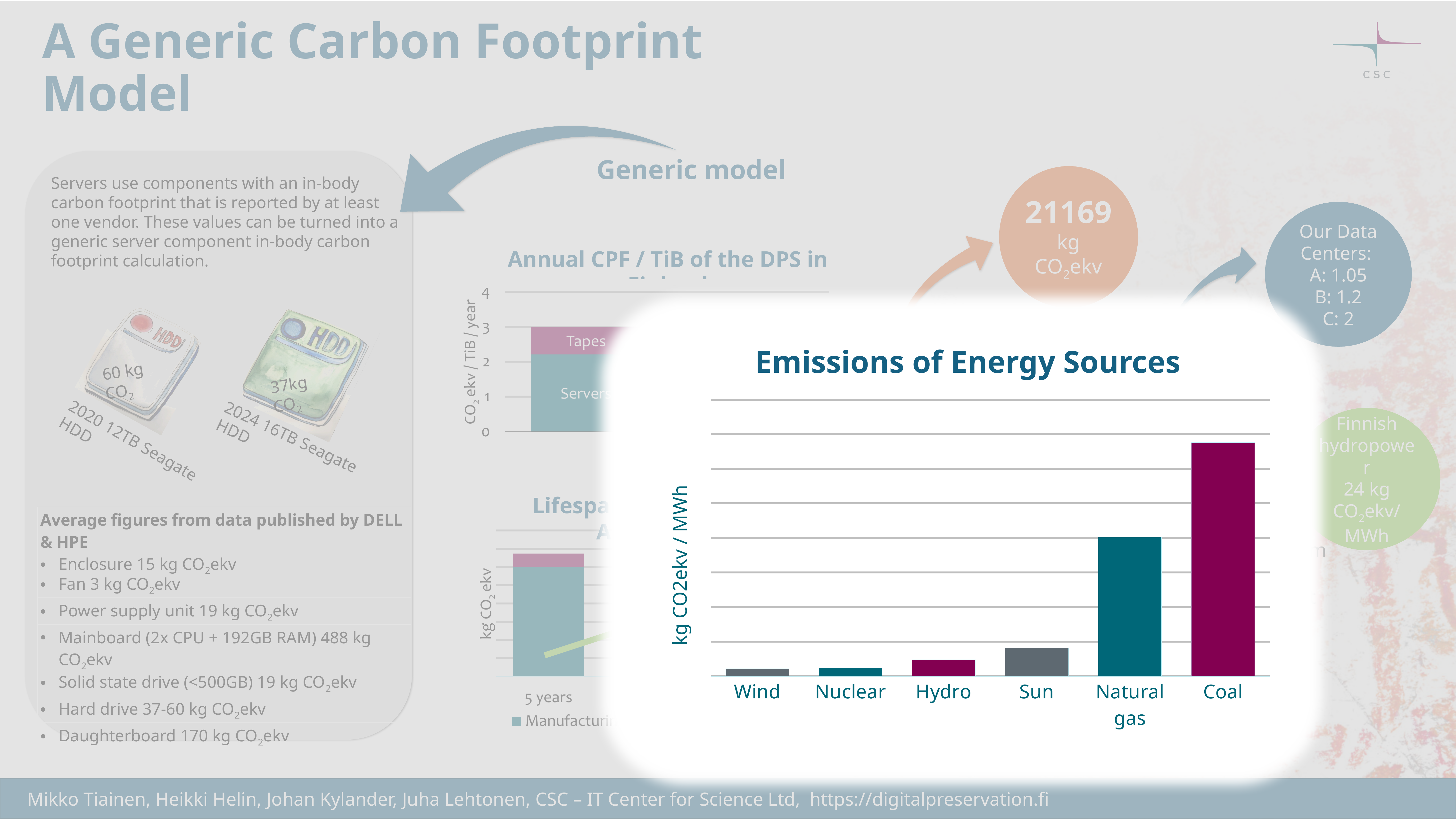
What is the title of the chart in the white panel on the slide? Emissions of Energy Sources In the "Emissions of Energy Sources" chart, which energy source has the highest emissions? Coal In the "Emissions of Energy Sources" chart, do the bar values generally rise or fall from Wind on the left to Coal on the right? rise What kind of chart is the "Emissions of Energy Sources" chart? bar chart In the "Emissions of Energy Sources" chart, which has higher emissions, Hydro or Sun? Sun In the "Emissions of Energy Sources" chart, which has higher emissions, Wind or Coal? Coal How many energy sources are shown in the "Emissions of Energy Sources" chart? 6 In the "Emissions of Energy Sources" chart, which energy source is the second highest? Natural gas In the "Emissions of Energy Sources" chart, which has higher emissions, Sun or Natural gas? Natural gas What is the y-axis label of the "Emissions of Energy Sources" chart? kg CO2ekv / MWh